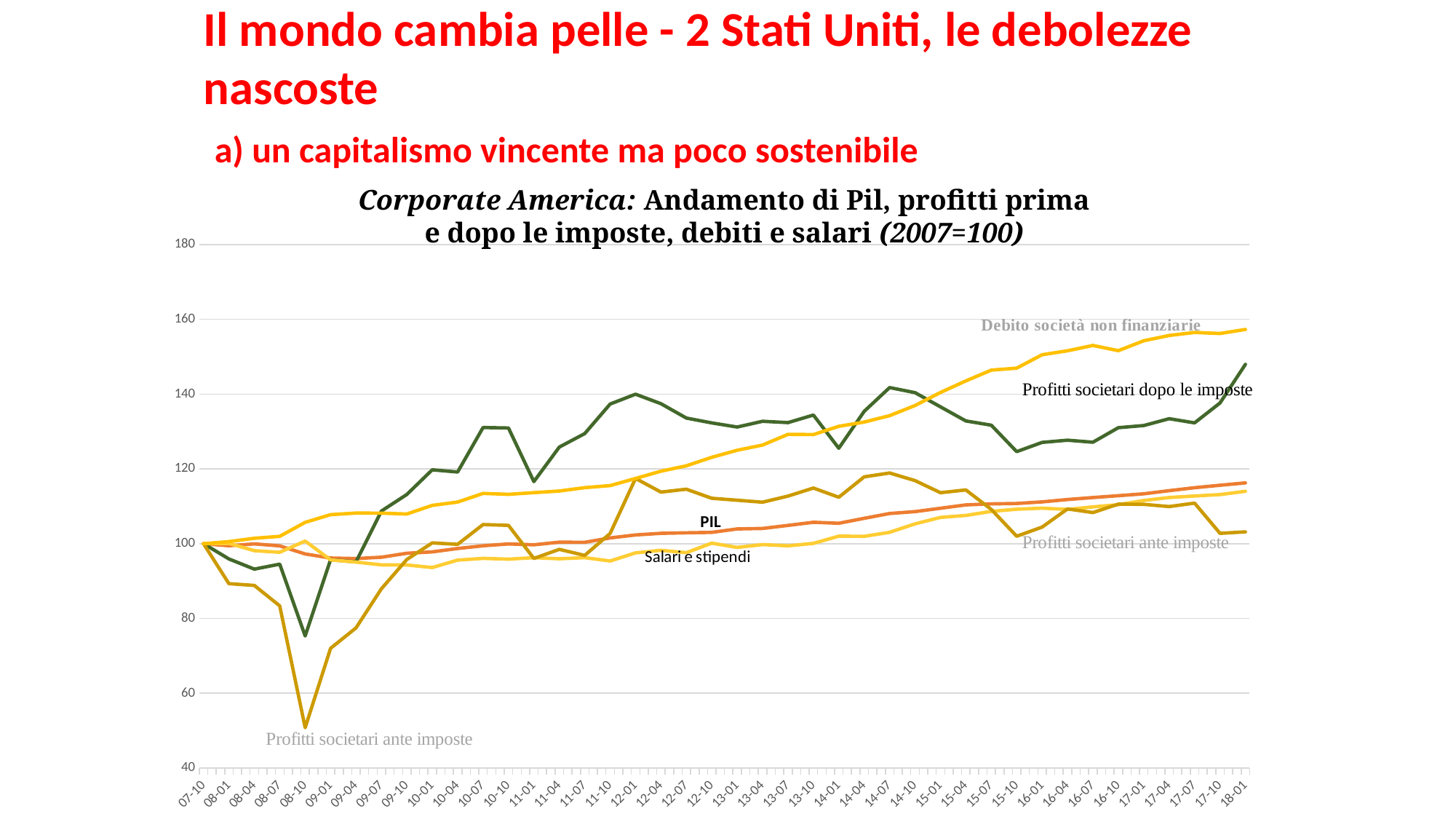
What is the base year index stated in the chart title (the value set to 100)? 2007=100 What kind of chart is shown on the slide? Line chart At 18-01, which is higher: Debito società non finanziarie or Profitti societari dopo le imposte? Debito società non finanziarie Which series has the lowest value at 08-10? Profitti societari ante imposte How many different series are labelled on the chart? 5 At 18-01, which is higher: PIL or Profitti societari ante imposte? PIL Which series has the highest value at the last point (18-01)? Debito società non finanziarie Is the value for Salari e stipendi at 18-01 greater or less than 100? greater Is the value for Debito società non finanziarie at 18-01 greater or less than 140? greater Does the Debito società non finanziarie series generally rise or fall from 07-10 to 18-01? Rise Is the value for Profitti societari dopo le imposte at 08-10 greater or less than 80? less